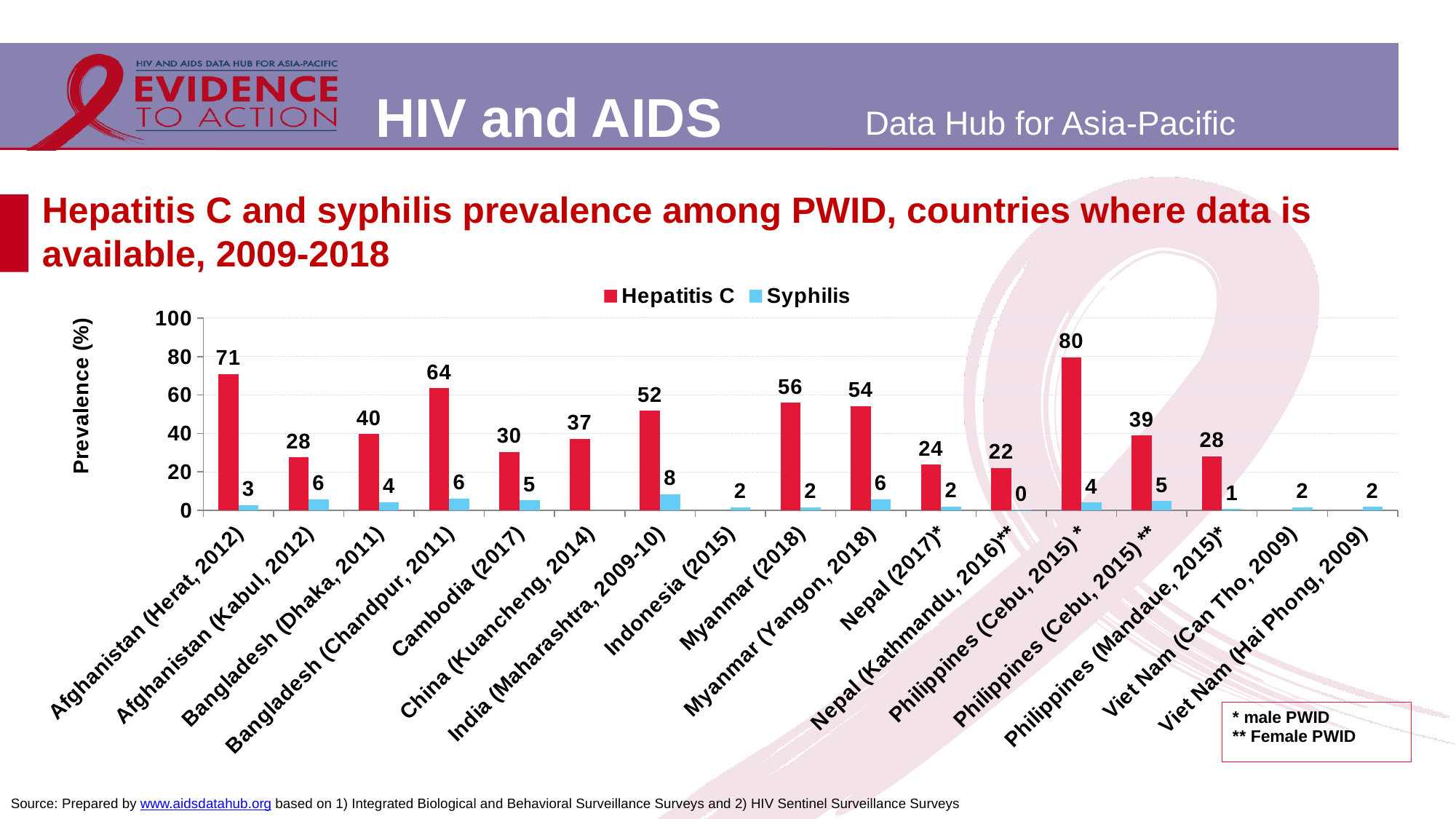
What is the label of the y axis? Prevalence (%) What is the syphilis prevalence for India (Maharashtra, 2009-10)? 8 What is the Hepatitis C prevalence for Bangladesh (Chandpur, 2011)? 64 What is the difference between the Hepatitis C prevalence for Myanmar (2018) and Myanmar (Yangon, 2018)? 2 How many series does the legend list? 2 Is the Hepatitis C prevalence for Bangladesh (Dhaka, 2011) greater or less than 60? less What is the Hepatitis C prevalence for Afghanistan (Herat, 2012)? 71 Which is larger, the Hepatitis C prevalence for Cambodia (2017) or for China (Kuancheng, 2014)? China (Kuancheng, 2014) Which category has the highest Hepatitis C prevalence? Philippines (Cebu, 2015) * What kind of chart is shown on the slide? bar chart How many categories are shown on the x axis? 17 Which category has the highest syphilis prevalence? India (Maharashtra, 2009-10)